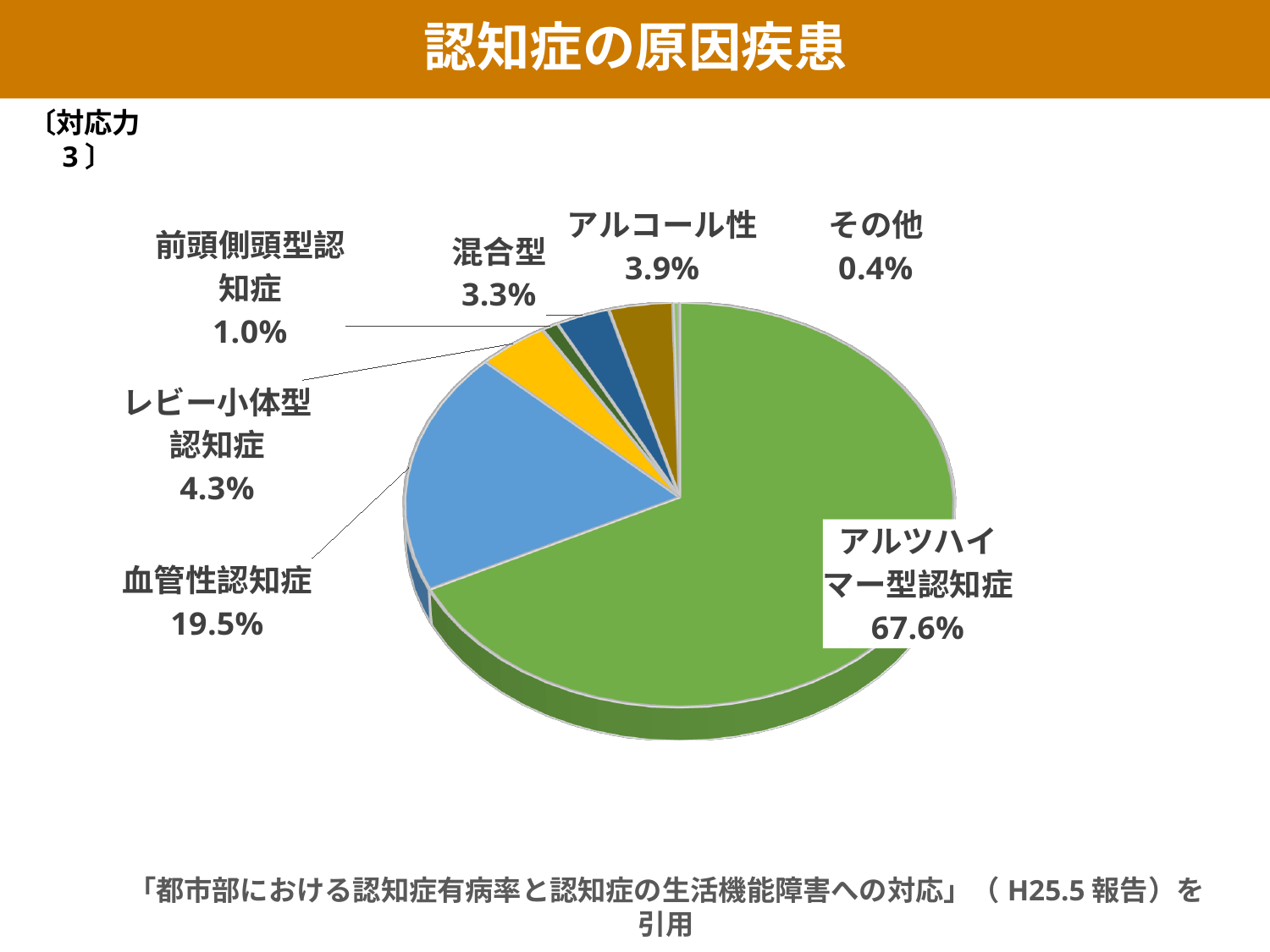
What is the value shown for レビー小体型認知症? 4.3% What is the value shown for 血管性認知症? 19.5% Which is larger, the value for レビー小体型認知症 or the value for アルコール性? レビー小体型認知症 Which category has the smallest slice of the pie? その他 How many categories are shown in the pie chart? 7 What share of the pie does アルツハイマー型認知症 account for? 67.6% What is the title of the slide? 認知症の原因疾患 What is the difference between the values for アルツハイマー型認知症 and 血管性認知症? 48.1% What is the value shown for 混合型? 3.3% What is the value shown for アルコール性? 3.9% What kind of chart is shown on the slide? Pie chart Which category has the largest slice of the pie? アルツハイマー型認知症